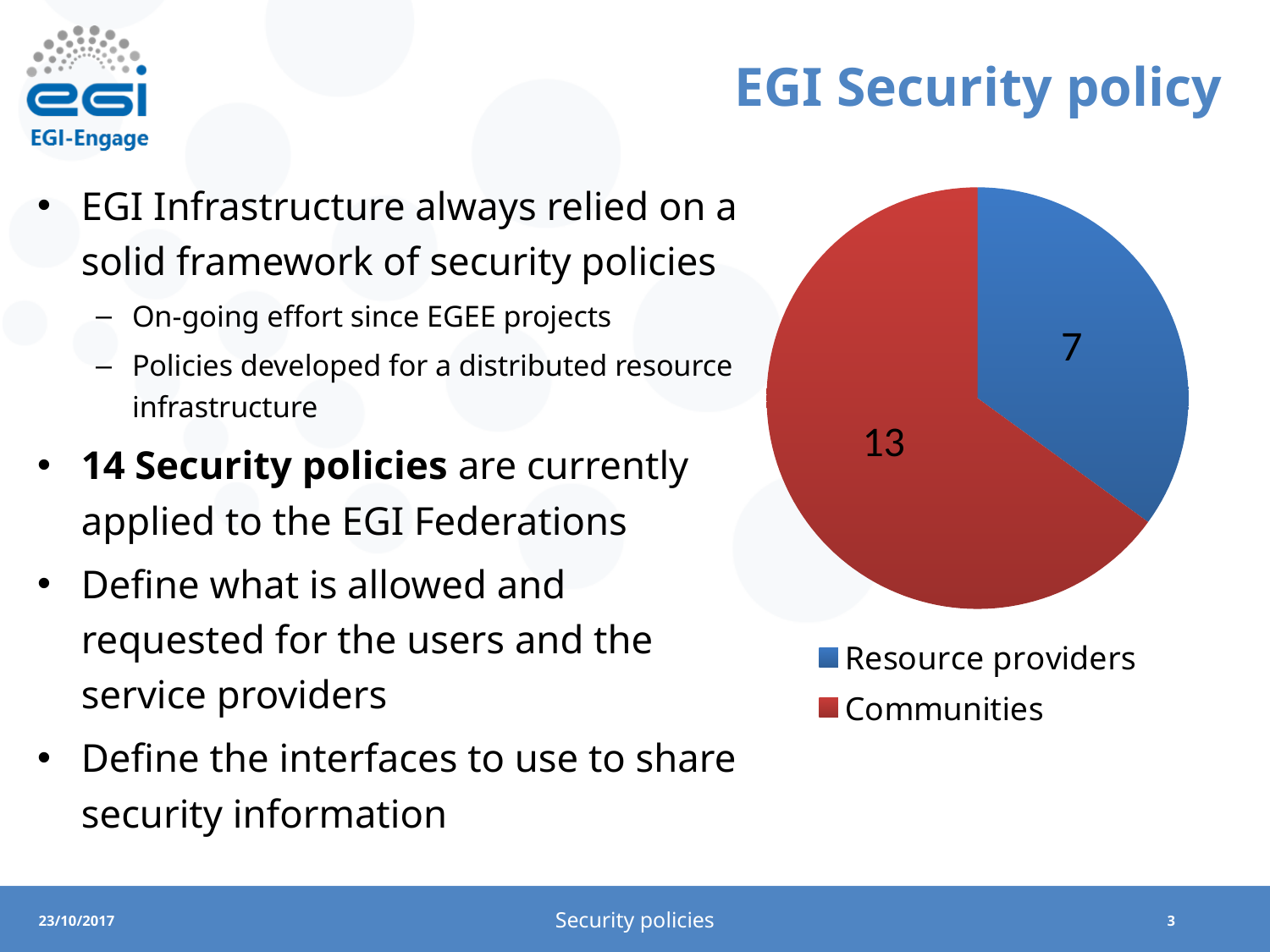
What is the value for Resource providers in the pie chart? 7 How many slices does the pie chart have? 2 What is the total of the two values in the pie chart? 20 Which is larger, Resource providers or Communities? Communities What share of the pie does Communities represent? 65% What colour is the Resource providers slice? blue Which slice of the pie chart is the largest? Communities What is the difference between the Communities value and the Resource providers value? 6 How many entries does the legend list? 2 What is the value for Communities in the pie chart? 13 What kind of chart is shown on the slide? pie chart Which slice of the pie chart is the smallest? Resource providers